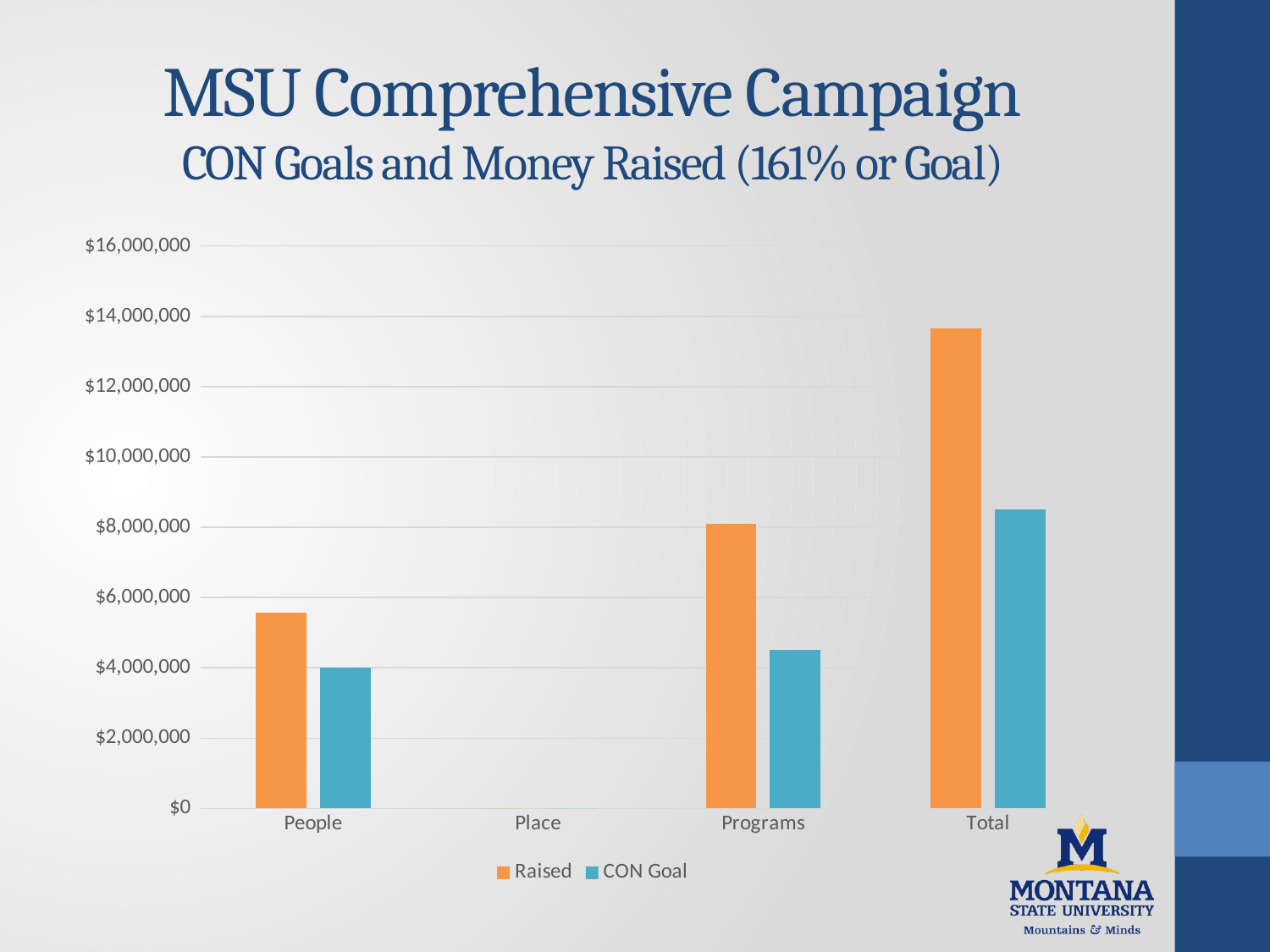
How many categories are shown on the x axis? 4 How many series does the legend list? 2 Which category has the highest CON Goal value? Total What kind of chart is shown on the slide? bar chart What colour are the Raised bars? orange Is the CON Goal value for Total greater or less than $10,000,000? less Is the CON Goal value for Programs greater or less than $6,000,000? less For People, which is larger: Raised or CON Goal? Raised Which is larger: the Raised value for Programs or the Raised value for People? Programs Which category has the highest Raised value? Total Is the Raised value for Total greater or less than $12,000,000? greater